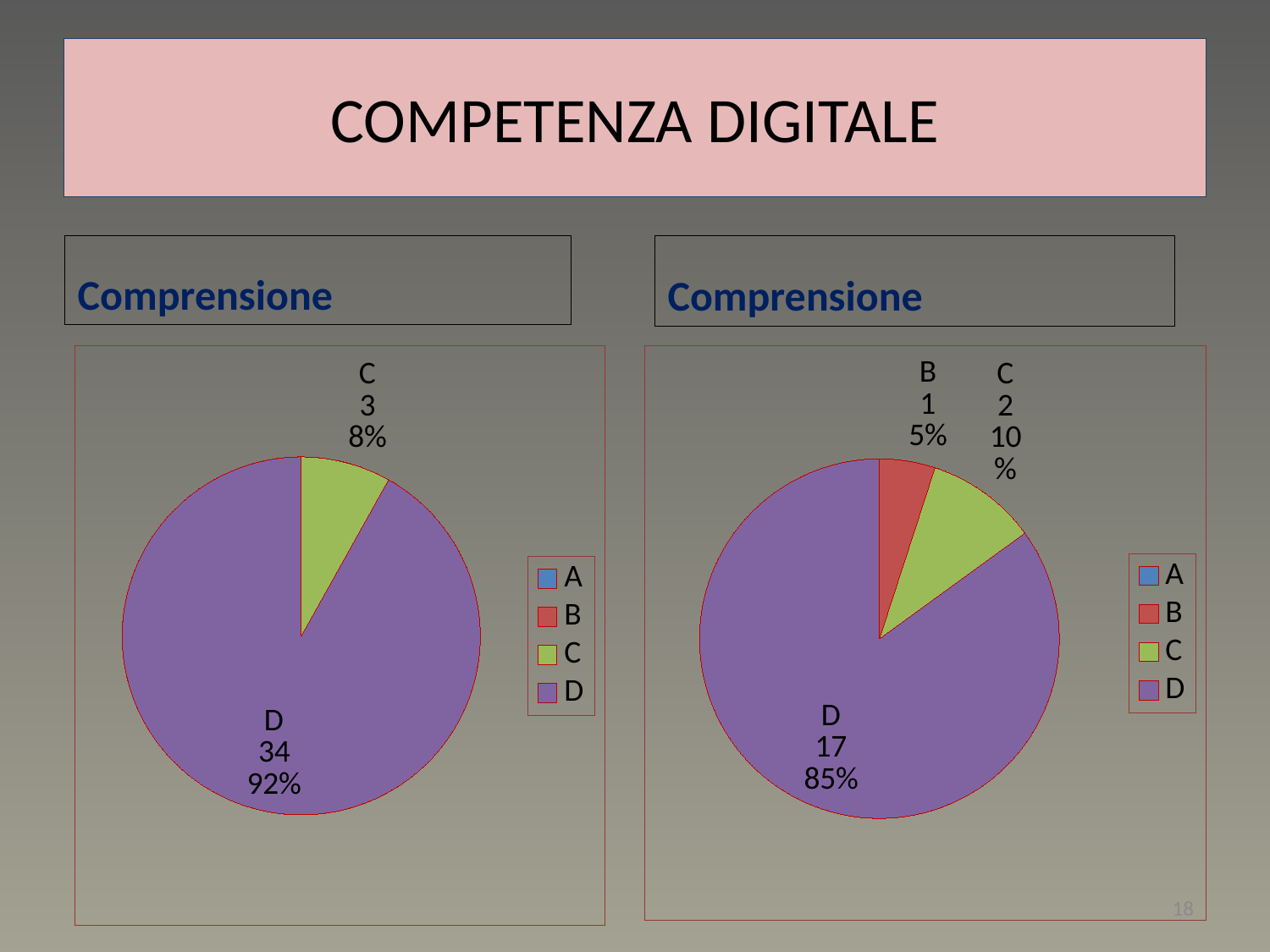
In the right pie chart, what share of the pie does D represent? 85% What type of chart is shown on the left side of the slide? Pie chart In the right pie chart, which category has the largest slice? D In the right pie chart, what share of the pie does B represent? 5% In the right pie chart, what is the value for C? 2 How many entries does the legend of the left chart list? 4 In the left pie chart, what share of the pie does C represent? 8% In the left pie chart, what is the value for D? 34 What is the title shown above each of the two charts? Comprensione In the left pie chart, what is the difference between the values for D and C? 31 In the right pie chart, which labelled category has the smallest slice? B In the right pie chart, which is larger, the value for C or the value for B? C